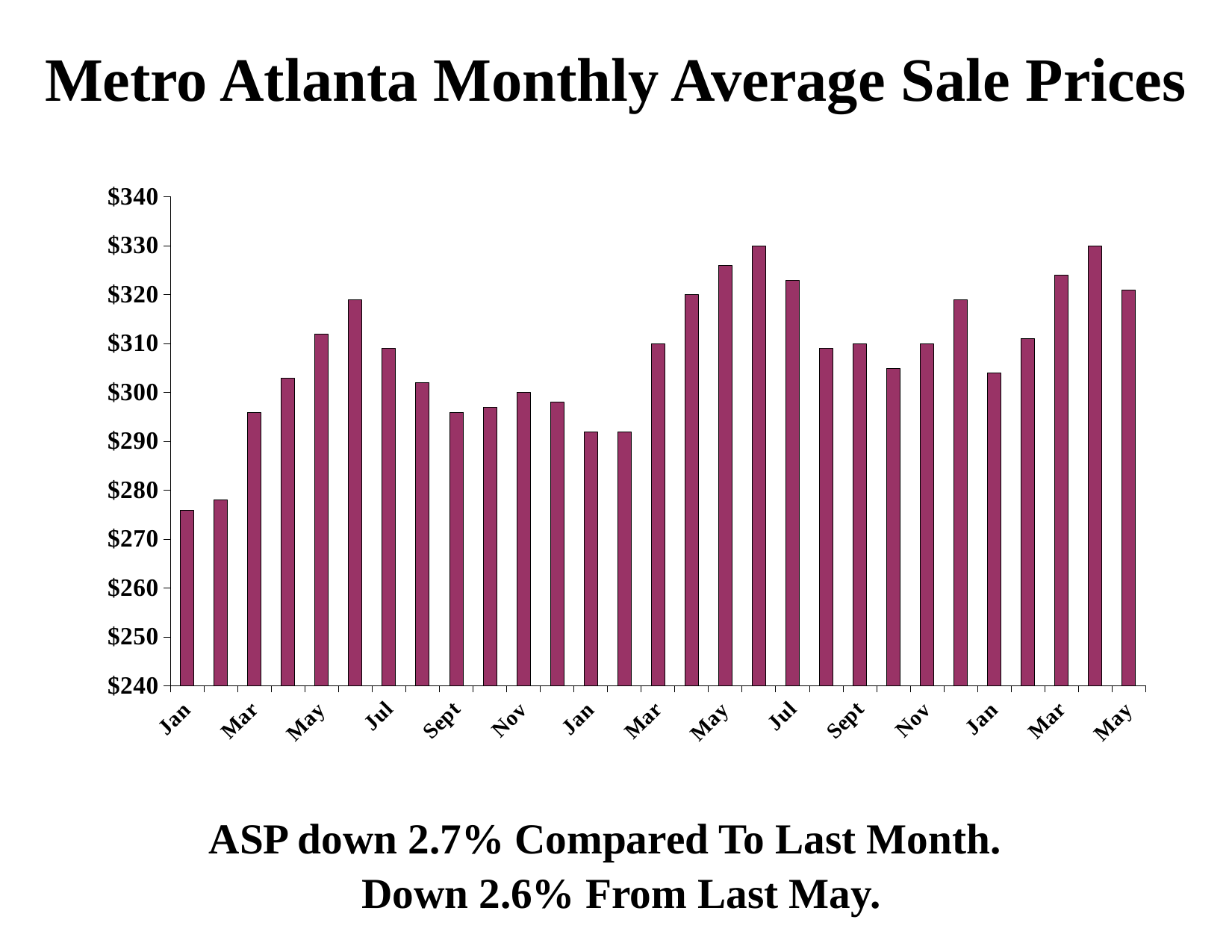
Is the value for the second May on the x axis greater or less than $320? greater Is the value for the first Jan on the x axis greater or less than $280? less Is the value for the second Jan on the x axis greater or less than $300? less What is the lowest value shown on the vertical axis? $240 Which is larger, the value for the first Jan or the value for the last May on the x axis? the last May How many bars are plotted in the chart? 29 What kind of chart is shown on the slide? bar chart Do the values rise or fall from the first Jan to the first Jul on the x axis? rise Which is larger, the value for the first May or the value for the second May on the x axis? the second May What is the title of the chart? Metro Atlanta Monthly Average Sale Prices